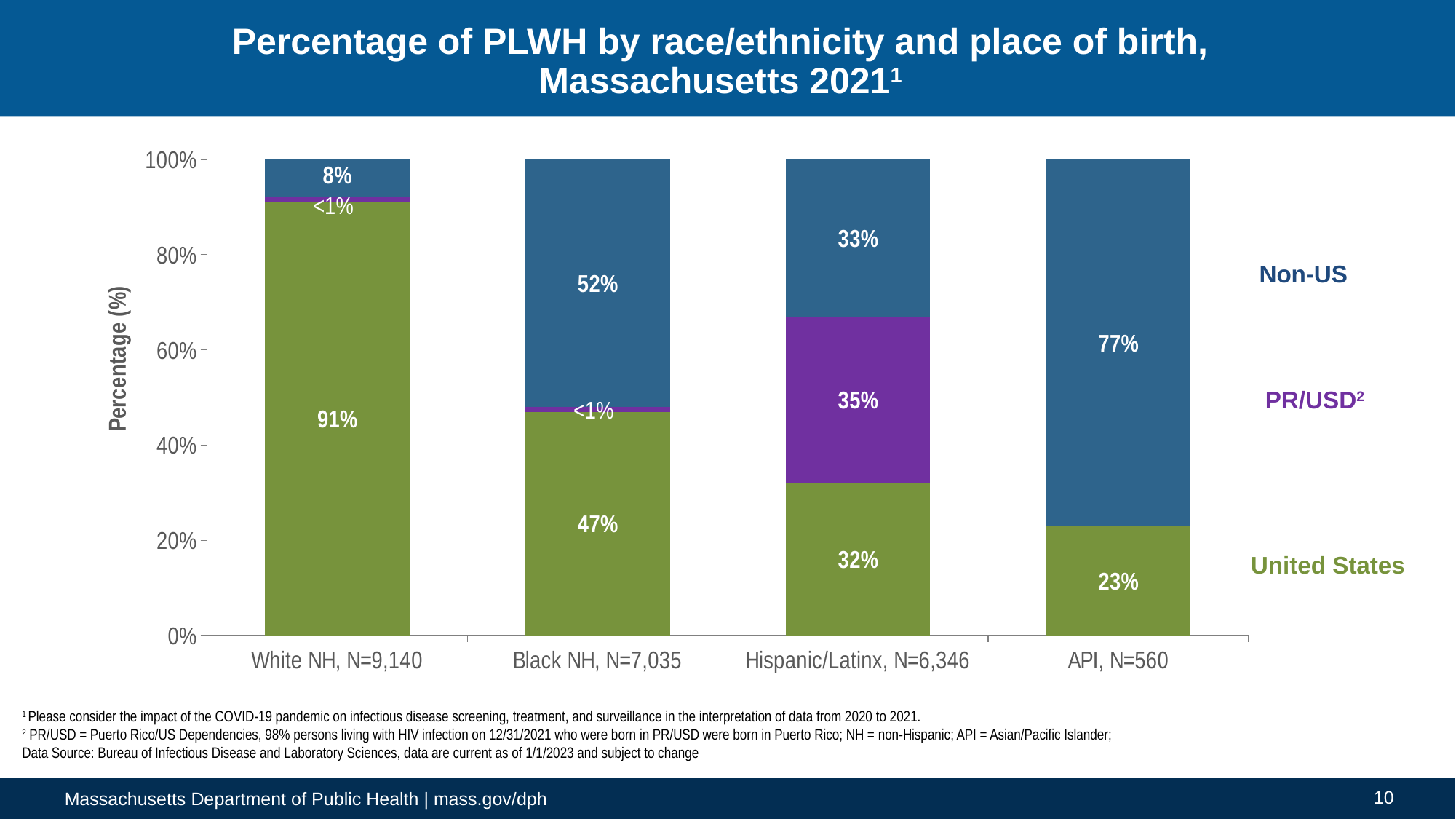
What percentage of Black NH PLWH were born outside the US (Non-US)? 52% What percentage of API PLWH were born in the United States? 23% What percentage of White NH PLWH were born in the United States? 91% What kind of chart is shown on the slide? Stacked bar chart Which race/ethnicity group has the lowest United States percentage? API, N=560 What is the difference between the Non-US percentage for API and for Hispanic/Latinx? 44% What percentage of Hispanic/Latinx PLWH were born in PR/USD? 35% Which is larger: the United States percentage for Black NH or for Hispanic/Latinx? Black NH What is the N value shown for the Hispanic/Latinx category? 6,346 How many race/ethnicity categories are shown on the x axis? 4 How many series (place-of-birth categories) does the chart show? 3 Which race/ethnicity group has the highest Non-US percentage? API, N=560